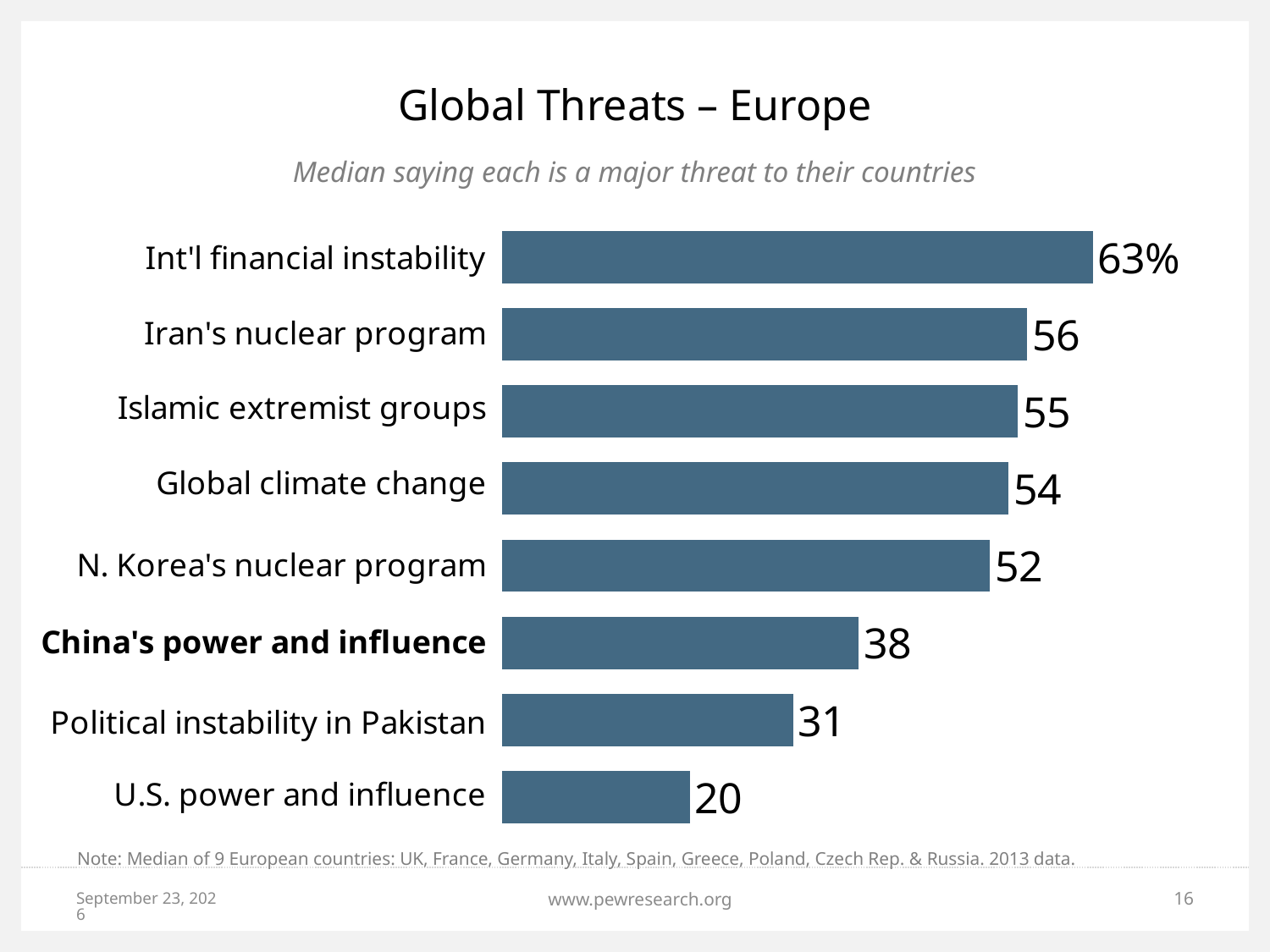
What is the value for U.S. power and influence? 20 Which category has the lowest value? U.S. power and influence What is the difference between the values for Iran's nuclear program and N. Korea's nuclear program? 4 What is the value for China's power and influence? 38 Which category has the highest value? Int'l financial instability How many categories are shown in the chart? 8 What is the difference between the values for China's power and influence and U.S. power and influence? 18 What is the value for Int'l financial instability? 63% What is the title of the chart? Global Threats – Europe What kind of chart is shown on the slide? Bar chart What is the value for Political instability in Pakistan? 31 Which is larger, the value for Global climate change or the value for Political instability in Pakistan? Global climate change